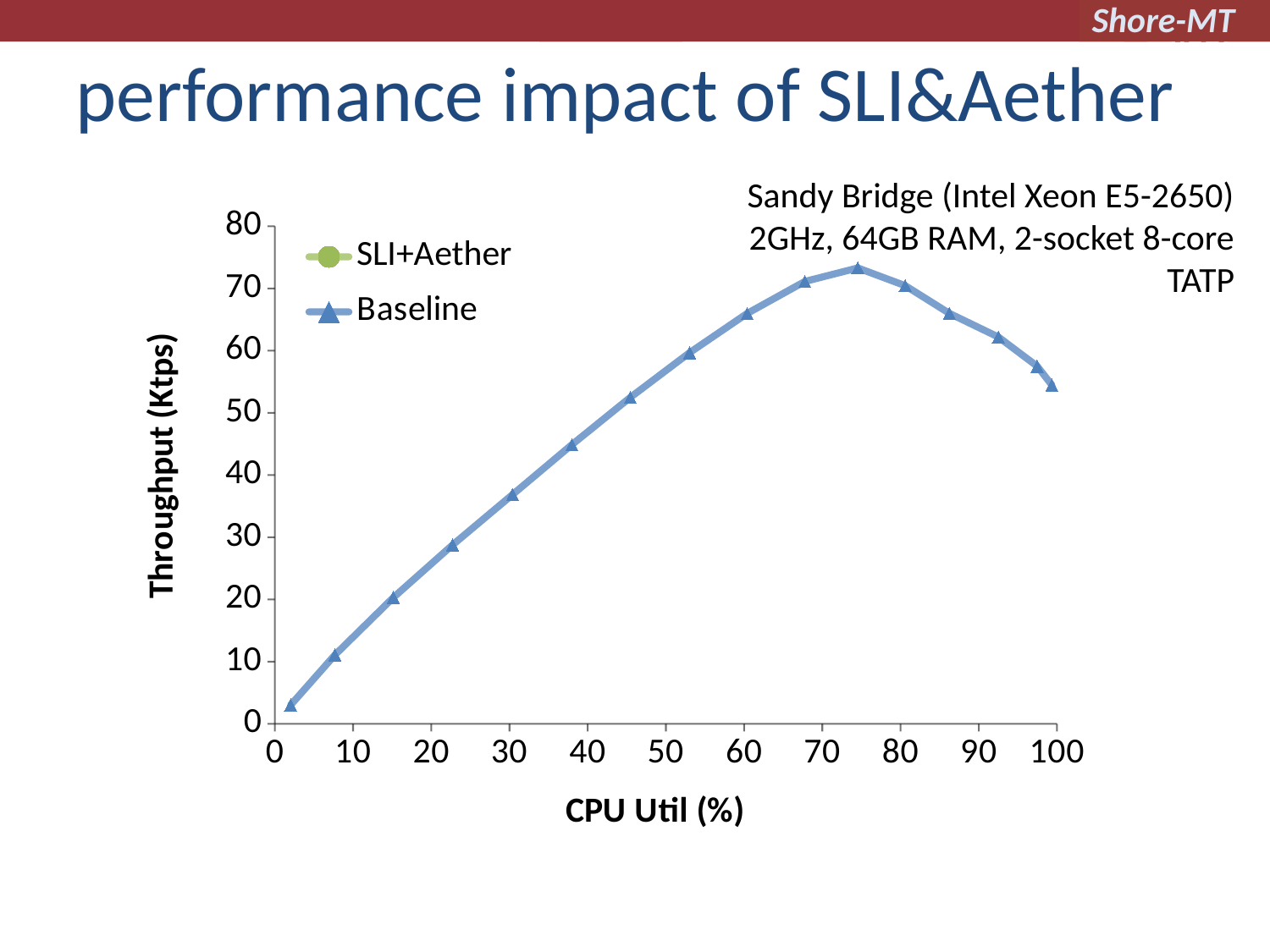
How does the Baseline throughput change as CPU Util increases from 0 to 100%? rises to a peak around 70-80% then falls Which series is larger at 70% CPU Util: the Baseline value or 60 Ktps? Baseline How many series does the legend list? 2 Is the Baseline throughput at the highest CPU Util point (near 100%) greater or less than 50? greater Is the Baseline throughput at 20% CPU Util greater or less than 30? less What is the label of the y axis? Throughput (Ktps) What are the two series named in the legend? SLI+Aether and Baseline Is the highest Baseline throughput value greater or less than 70? greater Does the Baseline throughput rise or fall between 80% and 100% CPU Util? fall What kind of chart is shown on the slide? line chart